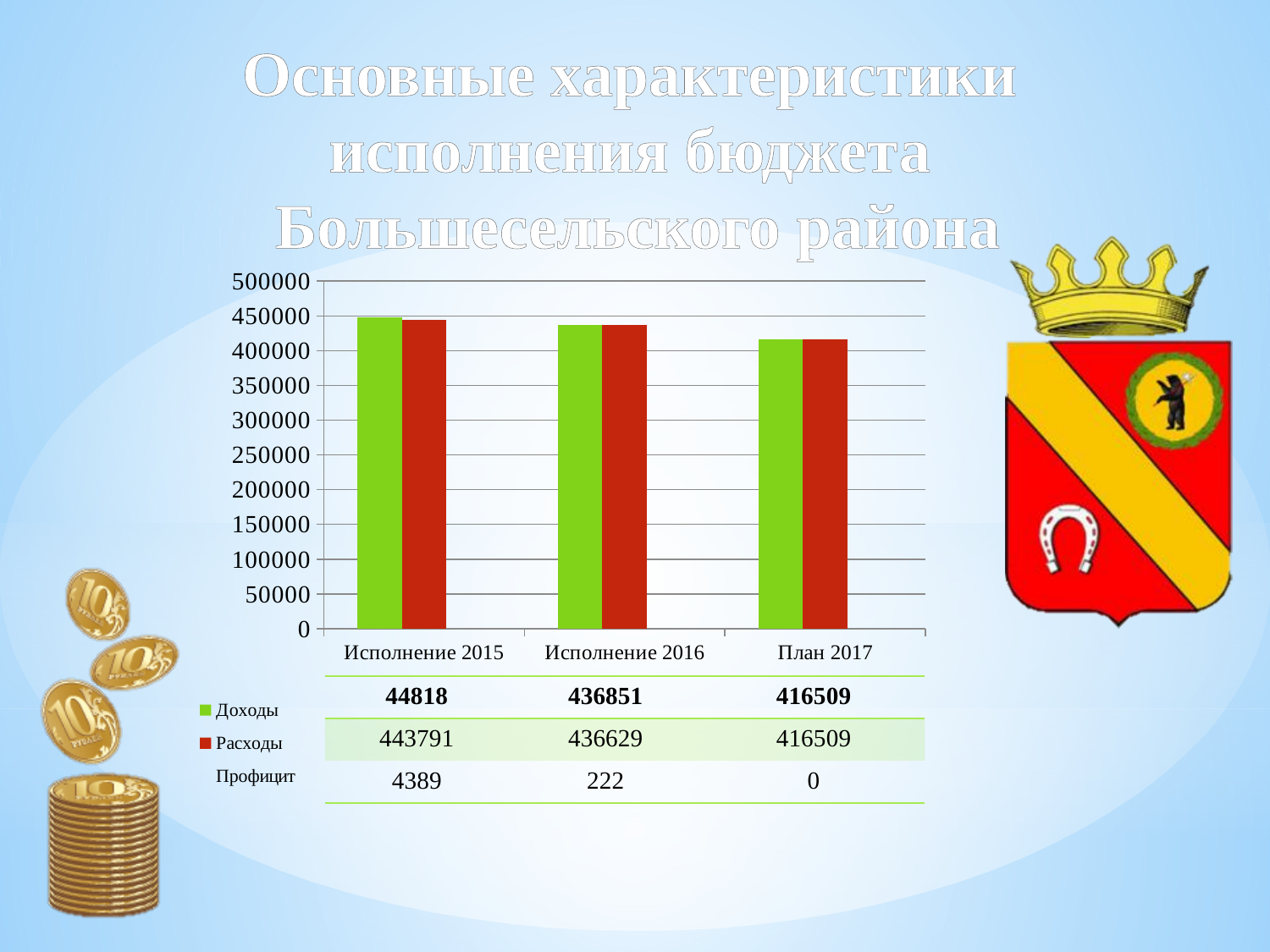
What is the value of Расходы for Исполнение 2015? 443791 Which category has the highest Расходы value? Исполнение 2015 What is the value of Расходы for Исполнение 2016? 436629 What is the Профицит value shown for План 2017? 0 What kind of chart is shown on the slide? bar chart How many categories are shown on the x axis of the chart? 3 Do the Расходы values rise or fall from Исполнение 2015 to План 2017? fall What is the value of Доходы for План 2017? 416509 Which is larger: Расходы for Исполнение 2015 or Расходы for Исполнение 2016? Исполнение 2015 What is the Профицит value shown for Исполнение 2015? 4389 Which category has the lowest Доходы value? План 2017 What is the difference between Доходы and Расходы for Исполнение 2016? 222